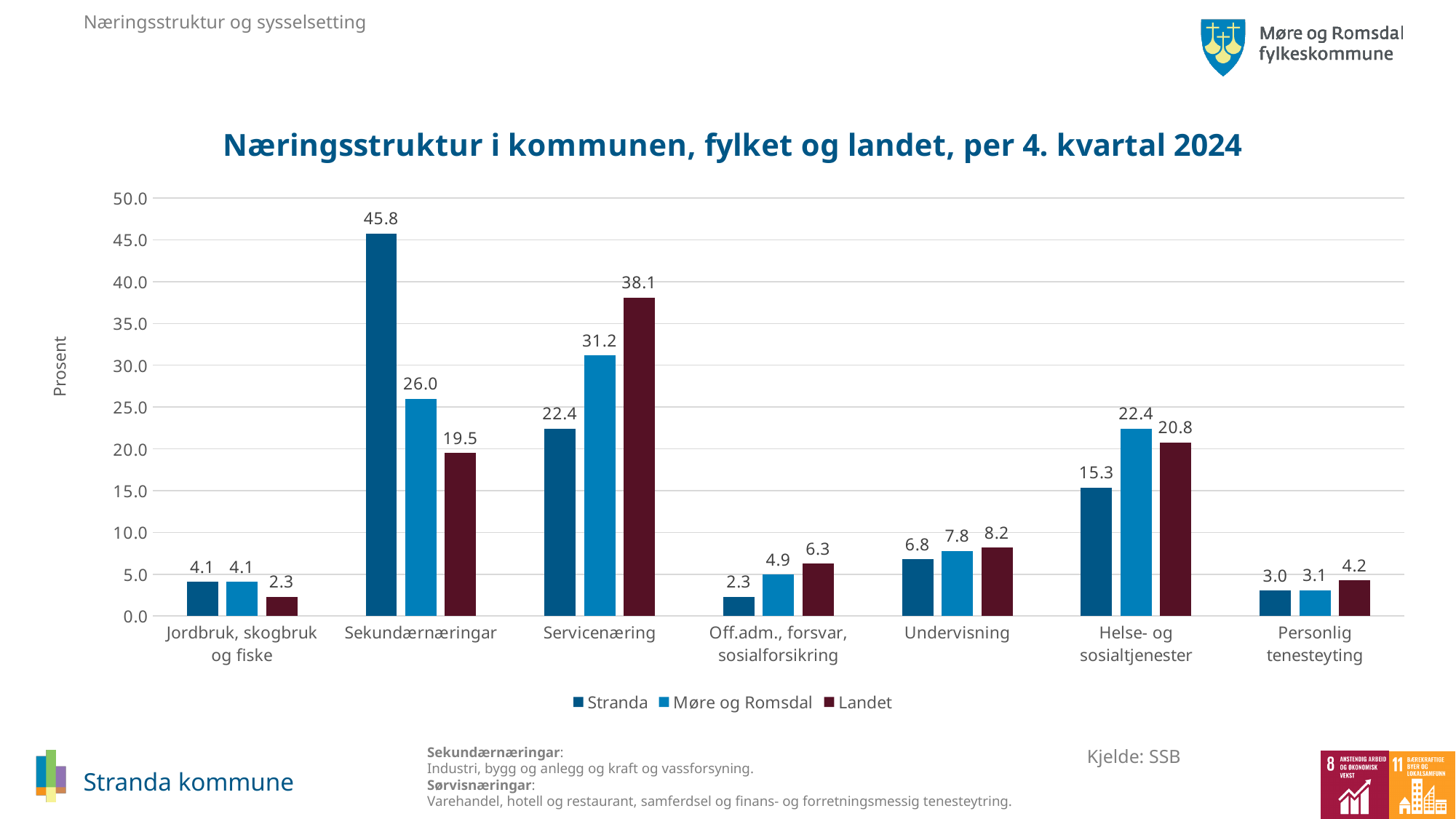
What is the value for Landet in Servicenæring? 38.1 What is the value for Møre og Romsdal in Helse- og sosialtjenester? 22.4 What is the value for Stranda in Sekundærnæringar? 45.8 Is the value for Møre og Romsdal in Servicenæring greater or less than 30.0? greater What is the difference between the Stranda and Landet values in Sekundærnæringar? 26.3 Which category has the highest value for Stranda? Sekundærnæringar Which category has the lowest value for Landet? Jordbruk, skogbruk og fiske What kind of chart is shown on the slide? Bar chart What is the label of the y axis? Prosent How many categories are shown on the x axis? 7 How many series does the legend list? 3 Which is larger in Undervisning: the value for Stranda or the value for Landet? Landet